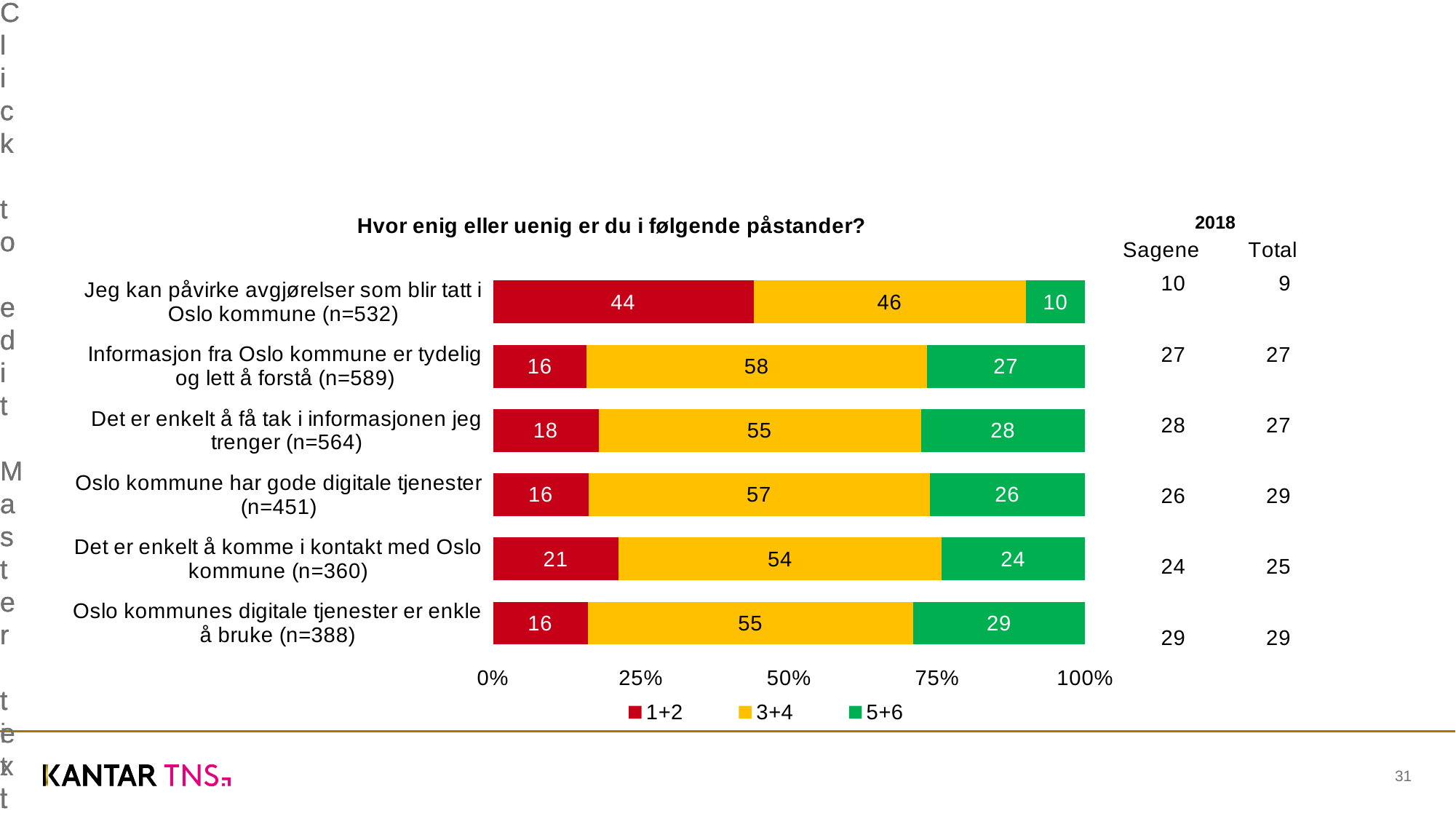
What is the value of the 1+2 series for "Jeg kan påvirke avgjørelser som blir tatt i Oslo kommune (n=532)"? 44 What is the value of the 3+4 series for "Informasjon fra Oslo kommune er tydelig og lett å forstå (n=589)"? 58 What is the title of the chart? Hvor enig eller uenig er du i følgende påstander? What is the total of the stacked bar for "Oslo kommune har gode digitale tjenester (n=451)"? 99 Which category has the lowest value in the 5+6 series? Jeg kan påvirke avgjørelser som blir tatt i Oslo kommune (n=532) How many categories (statements) are shown in the chart? 6 What is the difference between the 3+4 value and the 1+2 value for "Det er enkelt å komme i kontakt med Oslo kommune (n=360)"? 33 What kind of chart is shown on the slide? Stacked bar chart Which is larger: the 5+6 value for "Det er enkelt å få tak i informasjonen jeg trenger (n=564)" or the 5+6 value for "Det er enkelt å komme i kontakt med Oslo kommune (n=360)"? Det er enkelt å få tak i informasjonen jeg trenger (n=564) How many series does the legend list? 3 What is the value of the 5+6 series for "Oslo kommunes digitale tjenester er enkle å bruke (n=388)"? 29 Which category has the highest value in the 1+2 series? Jeg kan påvirke avgjørelser som blir tatt i Oslo kommune (n=532)